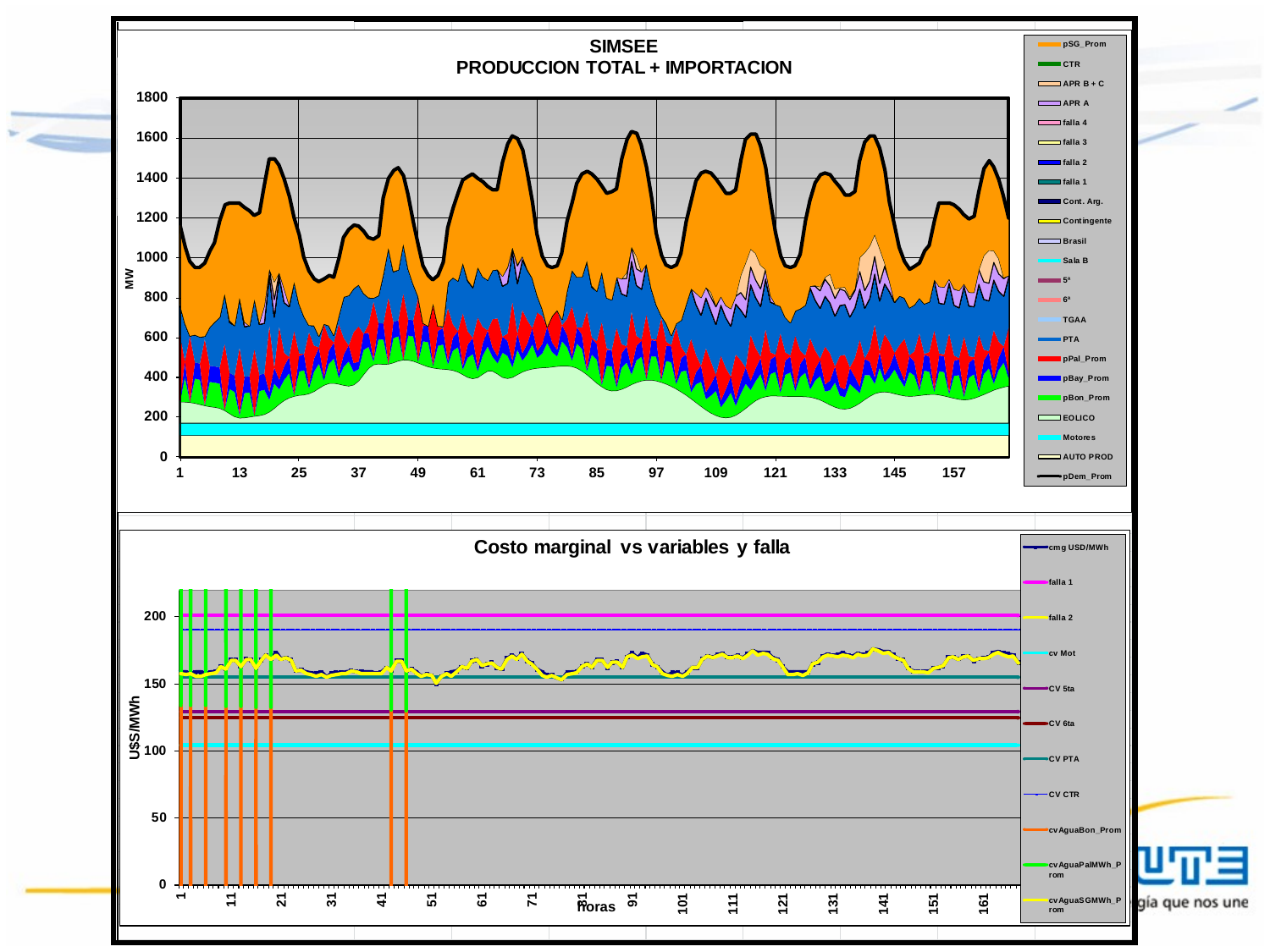
In the bottom chart, is the value of the CV 5ta line greater or less than 100? greater In the bottom chart, is the value of the cv Mot line greater or less than 150? less In the top chart, what is the label on the vertical axis? MW In the bottom chart, what is the label on the vertical axis? U$S/MWh What kind of chart is the top chart titled "SIMSEE PRODUCCION TOTAL + IMPORTACION"? Stacked area chart How many series does the legend of the top chart "SIMSEE PRODUCCION TOTAL + IMPORTACION" list? 23 In the bottom chart, is the value of the CV CTR line greater or less than 150? greater How many series does the legend of the bottom chart "Costo marginal vs variables y falla" list? 11 What kind of chart is the bottom chart titled "Costo marginal vs variables y falla"? Line chart